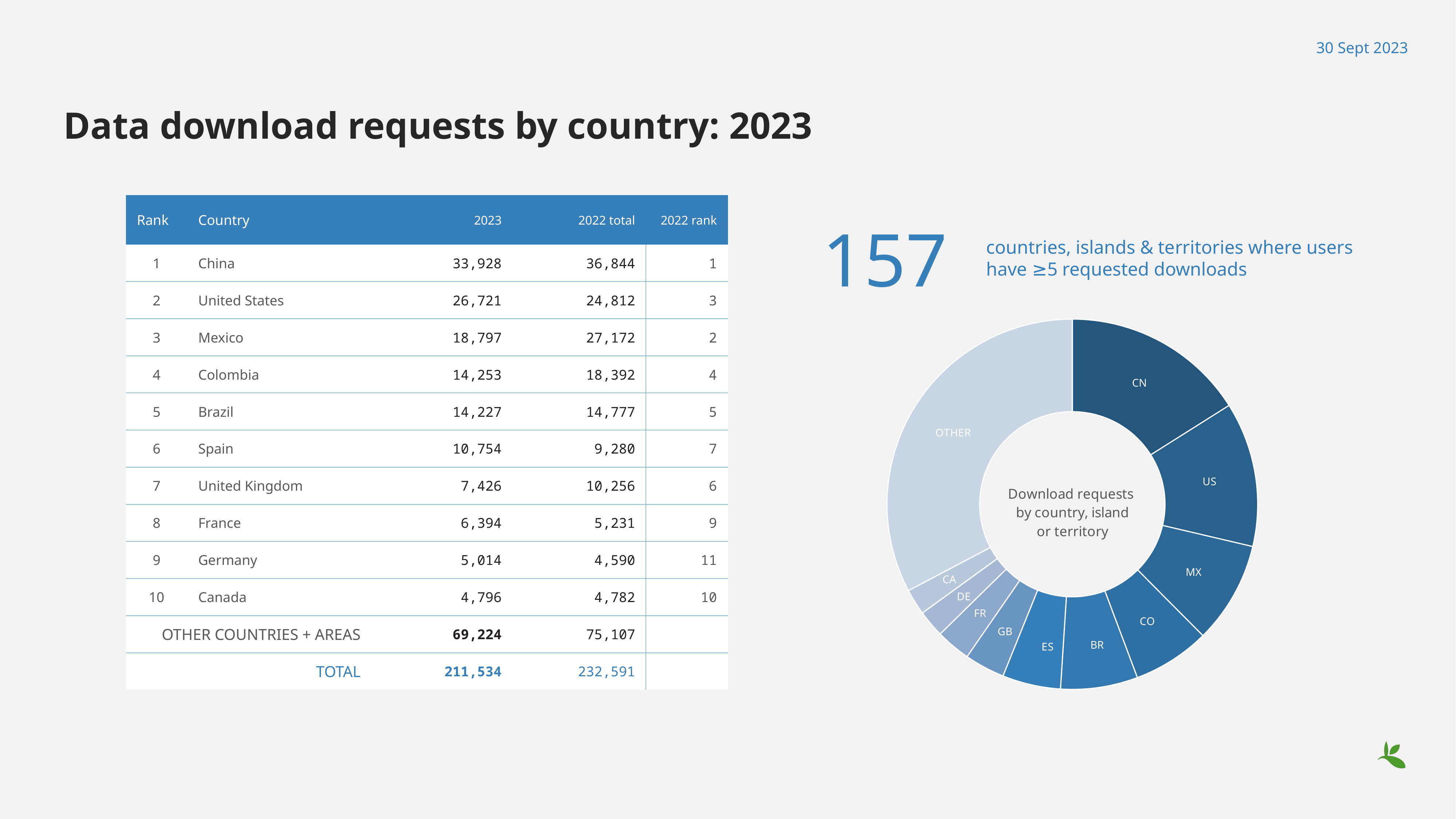
In the donut chart, which slice is larger, OTHER or CN? OTHER Which labelled country has the smallest slice in the donut chart? CA How many slices does the donut chart have? 11 According to the table, what is the difference between China's and the United States' 2023 download requests? 7,207 According to the table, what is the total number of download requests in 2023? 211,534 What text is printed in the centre of the donut chart? Download requests by country, island or territory According to the table, by how much did Mexico's download requests fall from the 2022 total to 2023? 8,375 What kind of chart is shown on the right of the slide? pie chart (donut) Which single country has the largest slice in the donut chart? CN What large number is shown above the donut chart for countries, islands & territories where users have ≥5 requested downloads? 157 According to the table, how many download requests did China make in 2023? 33,928 In the donut chart, which slice is larger, US or MX? US